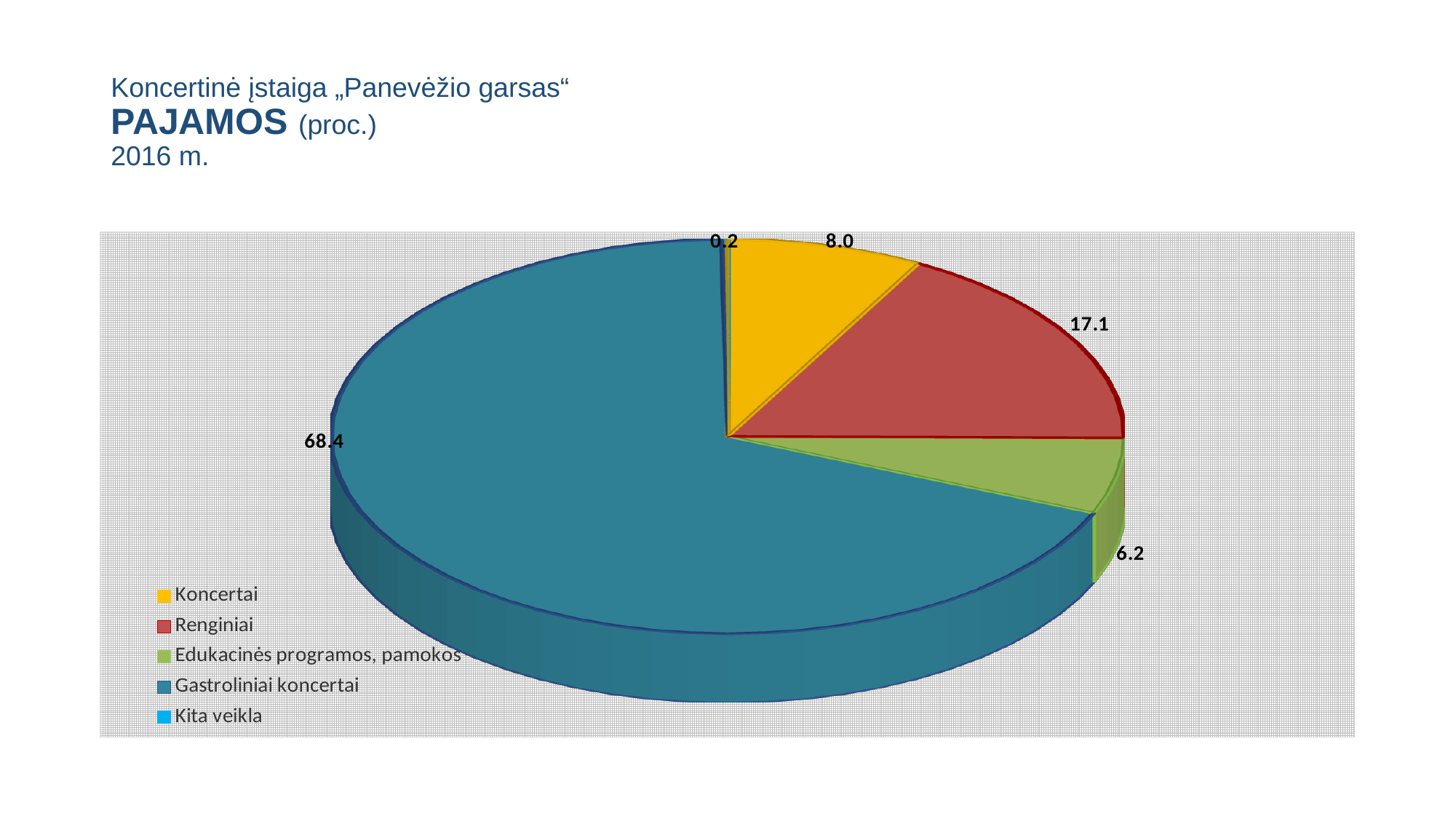
What kind of chart is shown on the slide? pie chart What is the value for Kita veikla? 0.2 Which is larger, the value for Koncertai or the value for Edukacinės programos, pamokos? Koncertai How many categories does the legend list? 5 Which year does the chart title refer to? 2016 m. Which category has the largest slice of the pie? Gastroliniai koncertai What is the value for Edukacinės programos, pamokos? 6.2 What is the value for Koncertai? 8.0 Which category has the smallest slice of the pie? Kita veikla What is the difference between the values for Renginiai and Koncertai? 9.1 What is the value for Renginiai? 17.1 What is the value for Gastroliniai koncertai? 68.4